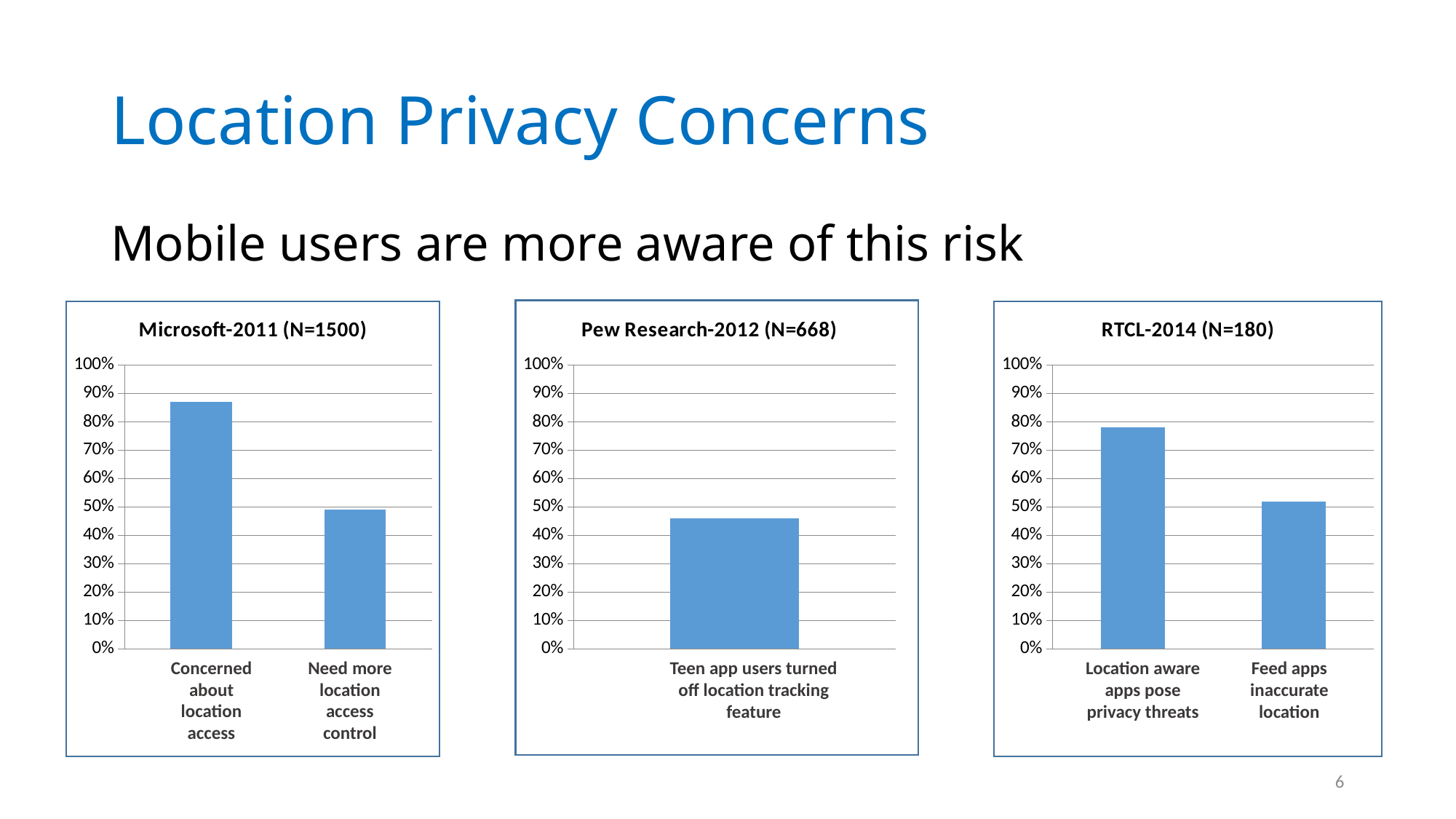
In the RTCL-2014 (N=180) chart, which category has the lowest value? Feed apps inaccurate location In the RTCL-2014 (N=180) chart, is the value for Location aware apps pose privacy threats greater or less than 70%? greater How many charts are shown on the slide? 3 In the Microsoft-2011 (N=1500) chart, is the value for Need more location access control greater or less than 60%? less In the Microsoft-2011 (N=1500) chart, is the value for Concerned about location access greater or less than 80%? greater In the Microsoft-2011 (N=1500) chart, which category has the highest value? Concerned about location access What kind of chart is the Pew Research-2012 (N=668) chart? bar chart In the Pew Research-2012 (N=668) chart, how many bars are plotted? 1 In the RTCL-2014 (N=180) chart, which is larger: Location aware apps pose privacy threats or Feed apps inaccurate location? Location aware apps pose privacy threats In the Microsoft-2011 (N=1500) chart, how many categories are plotted? 2